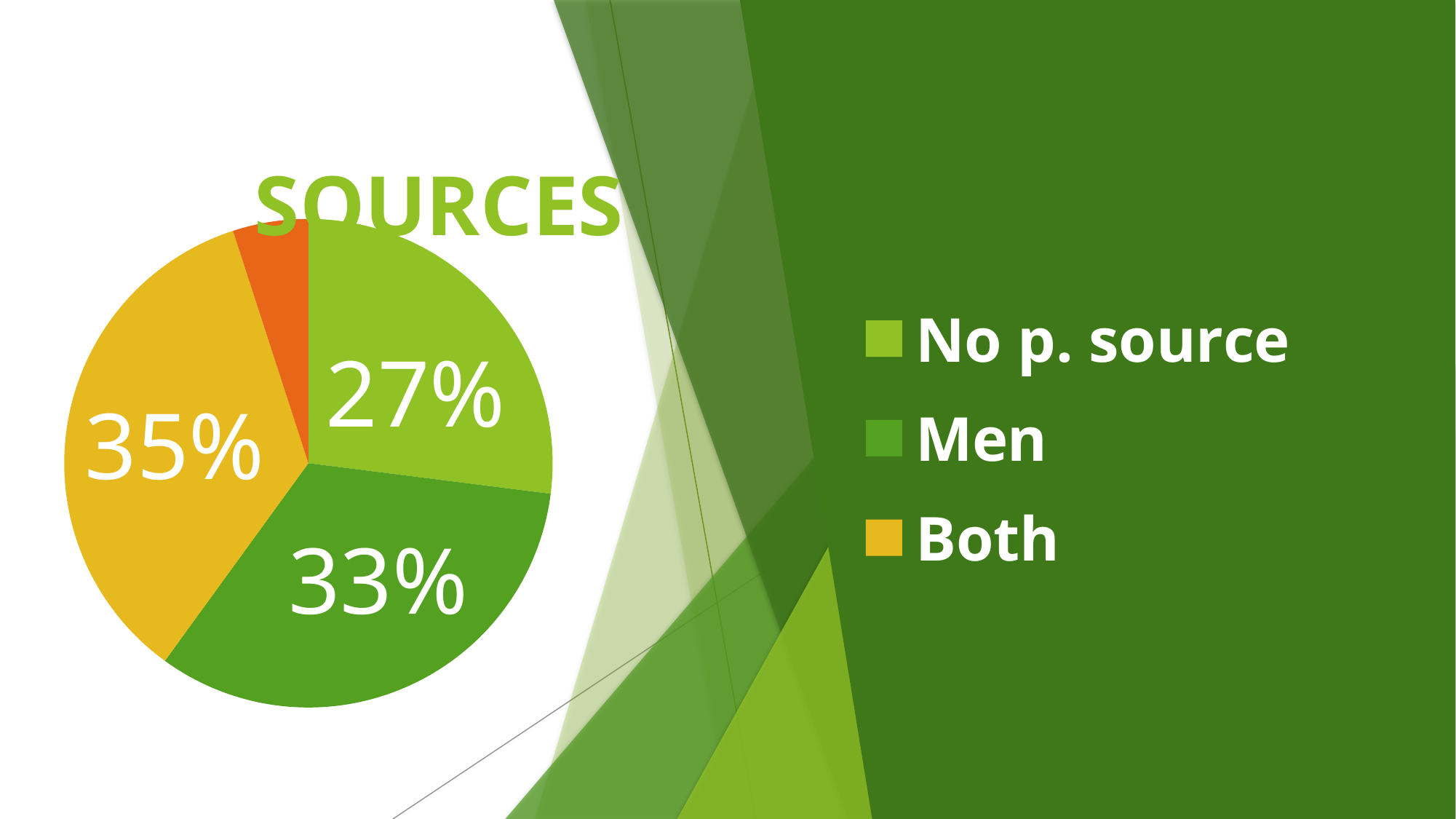
Is the share for 'Men' greater or less than 30%? greater What is the difference in percentage points between the 'Both' slice and the 'No p. source' slice? 8 What type of chart is shown on the slide? pie chart Which is larger, the 'Men' slice or the 'No p. source' slice? Men What percentage of the pie is labelled for the 'Both' slice? 35% What percentage of the pie is labelled for the 'No p. source' slice? 27% What is the title of the chart? SOURCES What percentage of the pie is labelled for the 'Men' slice? 33% Which legend category has the largest share of the pie? Both How many slices does the pie chart have? 4 What colour is the 'Both' slice in the pie chart? yellow How many entries does the legend list? 3